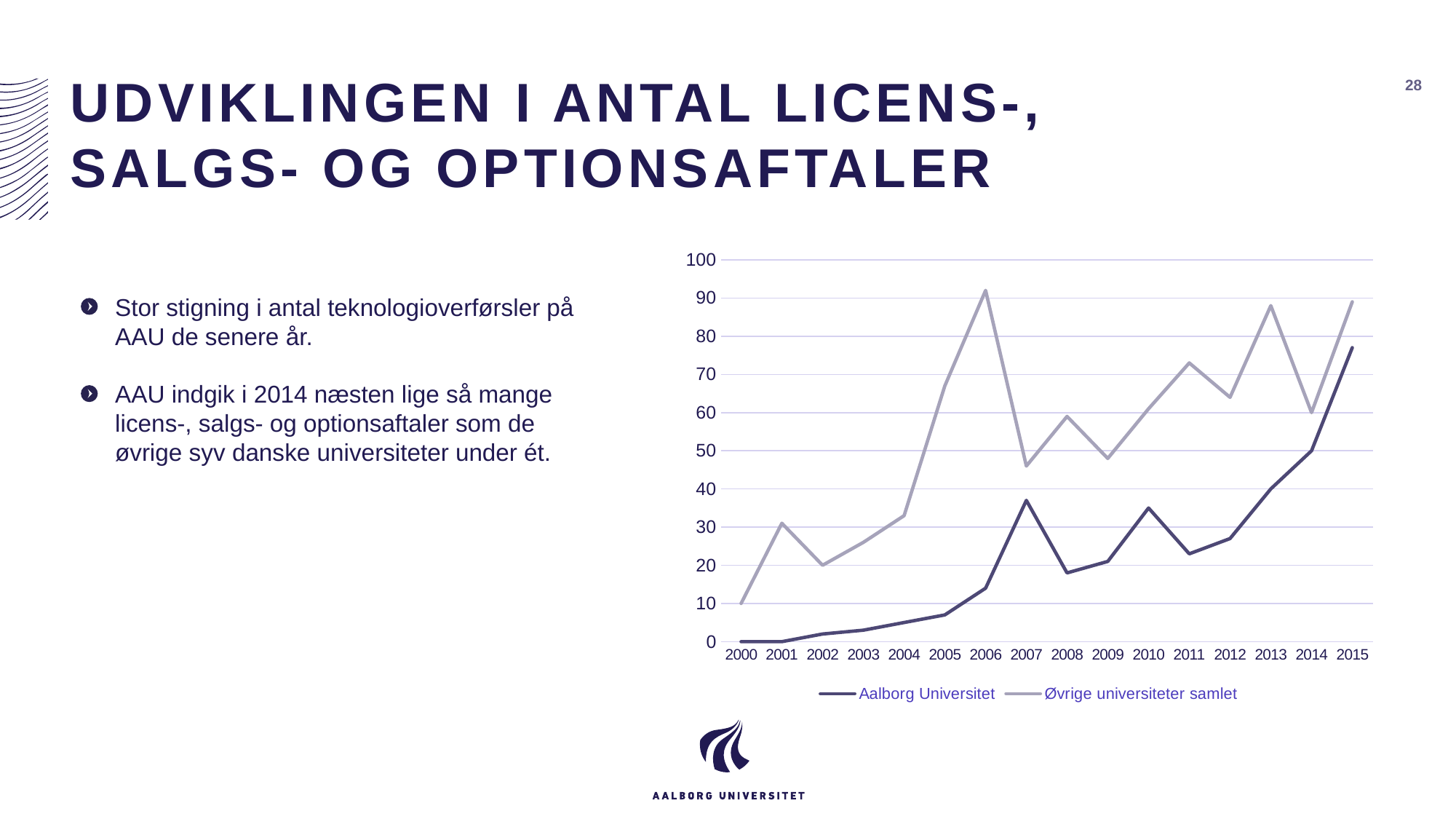
Is the value for Øvrige universiteter samlet in 2002 greater or less than 30? less Does the Aalborg Universitet series generally rise or fall from 2000 to 2015? Rise Which series does the legend list first? Aalborg Universitet In which year does the Aalborg Universitet series reach its highest value? 2015 What kind of chart is shown on the slide? Line chart How many years are plotted along the x axis of the chart? 16 Is the value for Aalborg Universitet in 2007 greater or less than 30? greater In 2014, which series has the higher value, Aalborg Universitet or Øvrige universiteter samlet? Øvrige universiteter samlet How many series does the chart's legend list? 2 In which year is the Øvrige universiteter samlet series at its lowest? 2000 Is the value for Øvrige universiteter samlet in 2006 greater or less than 80? greater